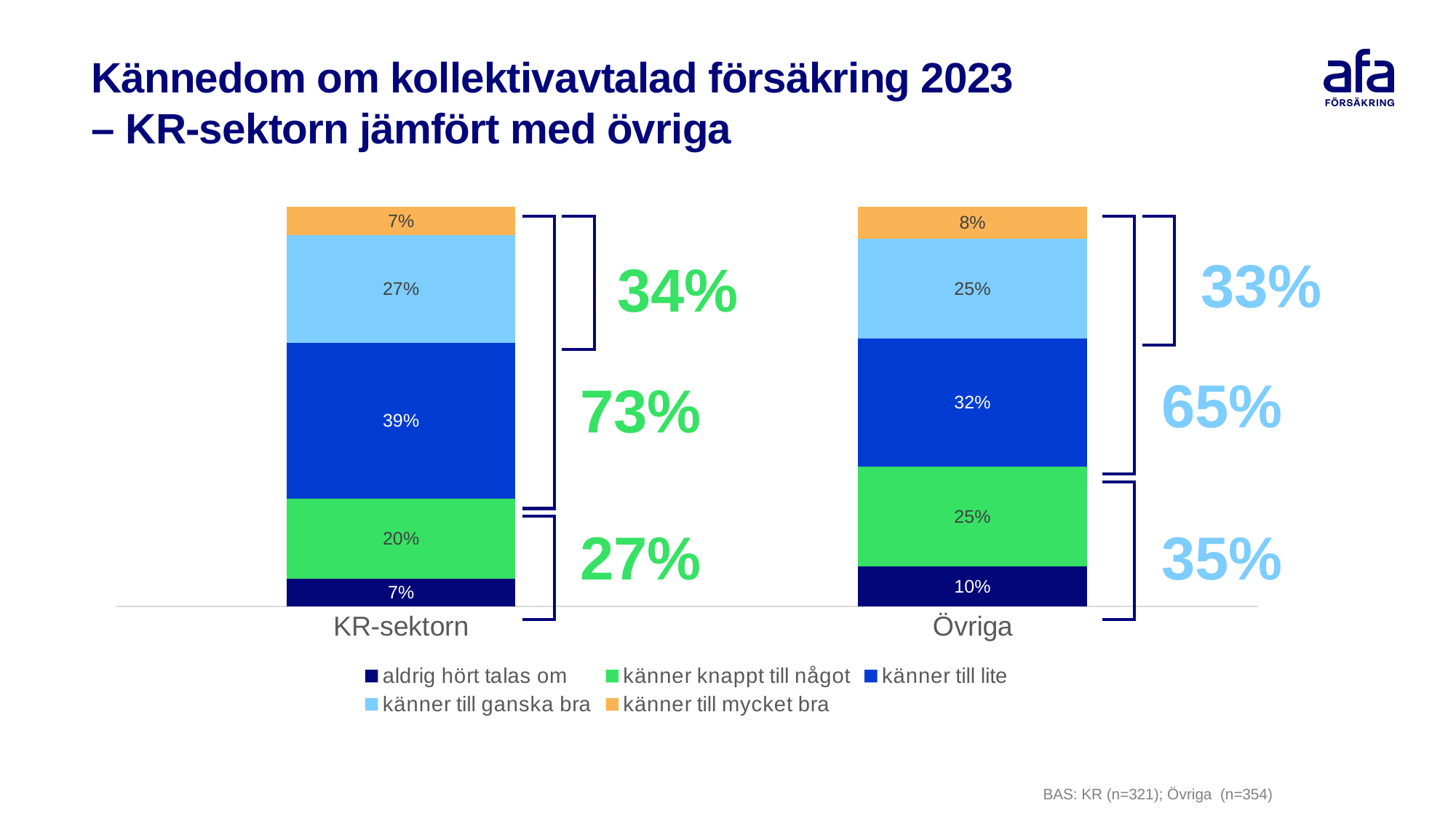
What kind of chart is shown on the slide? Stacked bar chart Which group has the larger share for "känner knappt till något", KR-sektorn or Övriga? Övriga Which response category has the largest share in the KR-sektorn bar? känner till lite What is the value for "känner till ganska bra" in the KR-sektorn bar? 27% Which response category has the smallest share in the Övriga bar? känner till mycket bra What percentage of Övriga respondents answered "aldrig hört talas om"? 10% What is the difference between the "känner till lite" values for KR-sektorn and Övriga? 7 percentage points How many bars (groups) are shown in the chart? 2 What is the combined share of "känner till ganska bra" and "känner till mycket bra" for KR-sektorn, as annotated on the slide? 34% What is the value for "känner till mycket bra" in the Övriga bar? 8% What percentage of KR-sektorn respondents answered "känner till lite"? 39% How many series does the legend list? 5